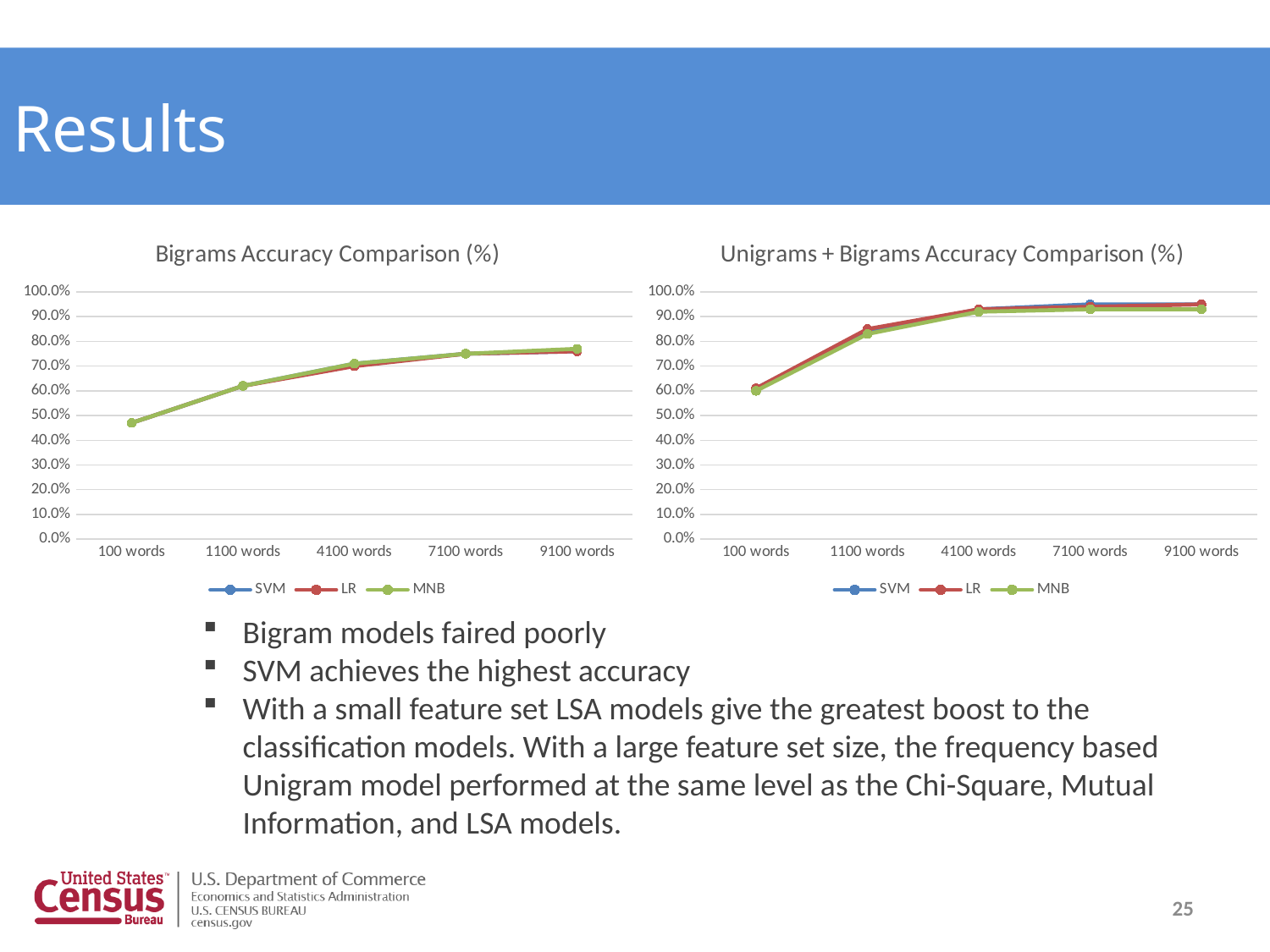
In the "Unigrams + Bigrams Accuracy Comparison (%)" chart, do the accuracy values rise or fall from 100 words to 9100 words? rise In the "Bigrams Accuracy Comparison (%)" chart, is the MNB value at 9100 words greater or less than 70.0%? greater Which series is drawn in green in the "Bigrams Accuracy Comparison (%)" chart? MNB What kind of chart is the "Bigrams Accuracy Comparison (%)" chart? line chart In the "Unigrams + Bigrams Accuracy Comparison (%)" chart, is the LR value at 1100 words greater or less than 80.0%? greater In the "Unigrams + Bigrams Accuracy Comparison (%)" chart, is the SVM value at 100 words greater or less than 50.0%? greater In the "Bigrams Accuracy Comparison (%)" chart, do the accuracy values rise or fall as the number of words increases? rise How many series does the legend of the "Unigrams + Bigrams Accuracy Comparison (%)" chart list? 3 What is the title of the chart on the right side of the slide? Unigrams + Bigrams Accuracy Comparison (%) How many feature-set sizes are shown on the x axis of the "Bigrams Accuracy Comparison (%)" chart? 5